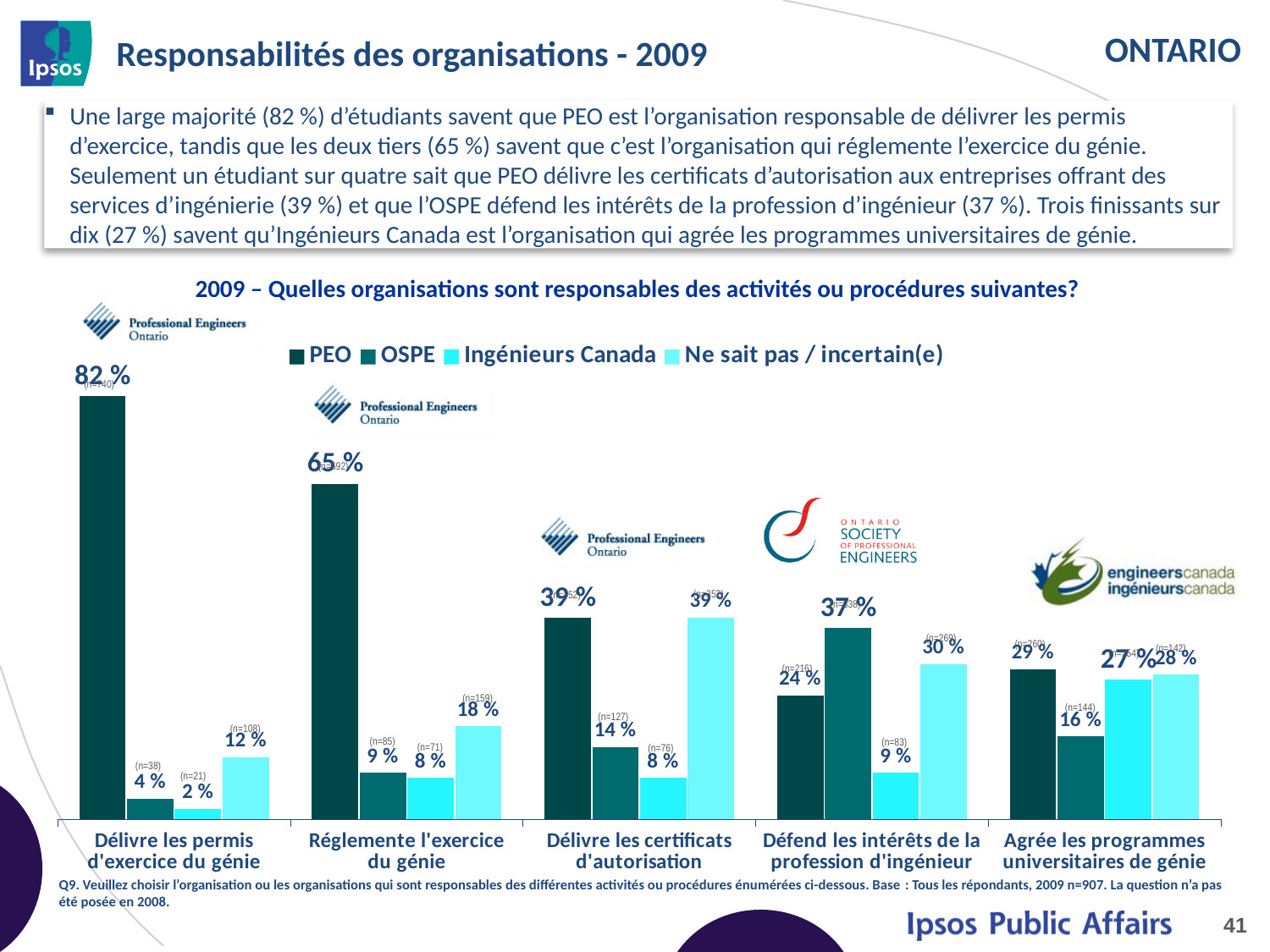
What is the difference between the PEO values for 'Délivre les permis d'exercice du génie' and 'Réglemente l'exercice du génie'? 17 % What is the OSPE value for 'Défend les intérêts de la profession d'ingénieur'? 37 % For 'Défend les intérêts de la profession d'ingénieur', which is larger: the PEO value or the OSPE value? OSPE Which category has the lowest Ingénieurs Canada value? Délivre les permis d'exercice du génie What is the 'Ne sait pas / incertain(e)' value for 'Réglemente l'exercice du génie'? 18 % How many series does the chart legend list? 4 Which category has the highest PEO value? Délivre les permis d'exercice du génie Which series is shown in the darkest colour in the chart legend? PEO How many categories are shown along the x axis of the chart? 5 What is the PEO value for 'Délivre les permis d'exercice du génie'? 82 % What type of chart is shown on the slide? bar chart What is the Ingénieurs Canada value for 'Agrée les programmes universitaires de génie'? 27 %